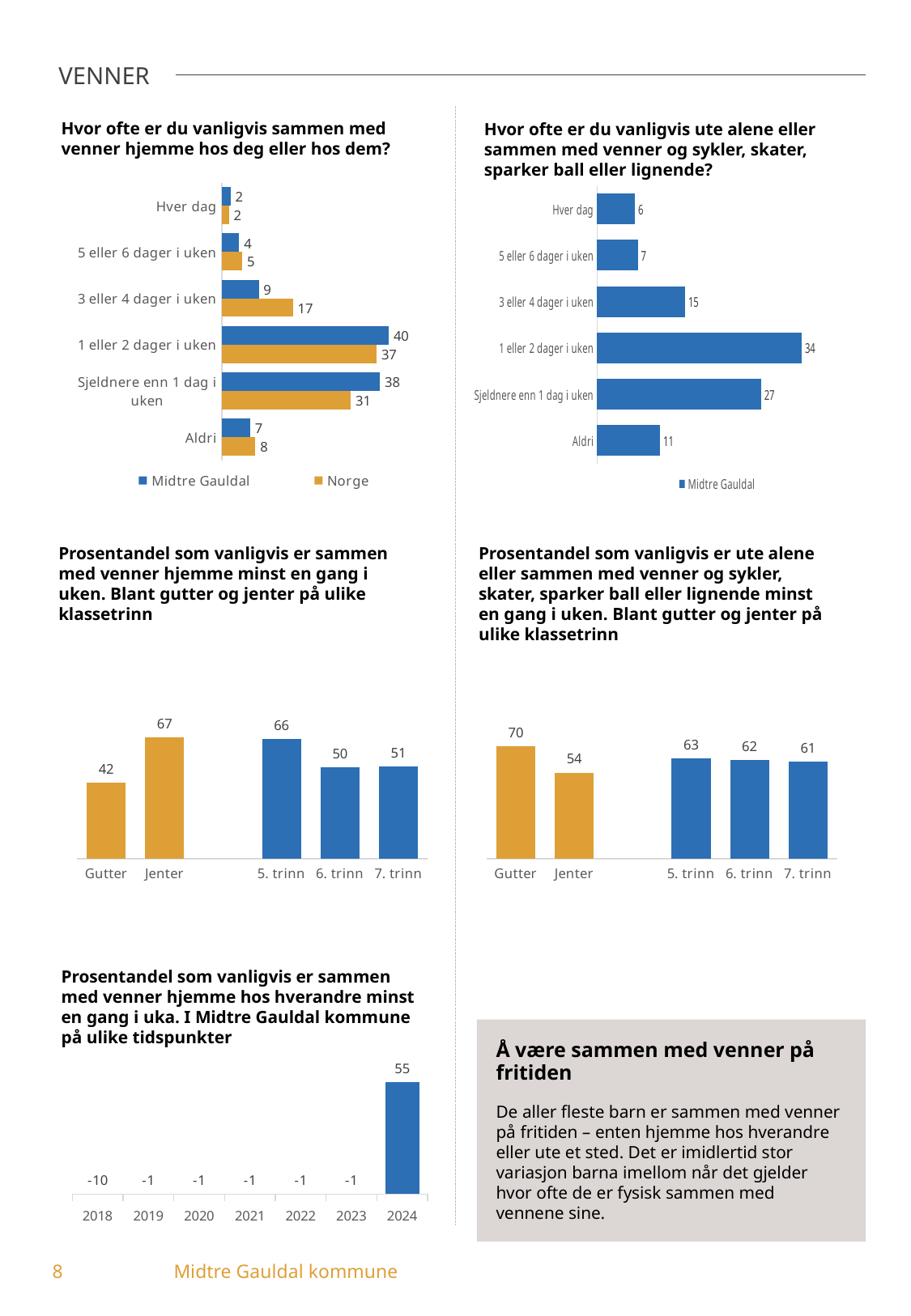
In the chart 'Hvor ofte er du vanligvis ute alene eller sammen med venner og sykler, skater, sparker ball eller lignende?', what is the value for 'Aldri'? 11 In the chart 'Prosentandel som vanligvis er ute alene eller sammen med venner og sykler, skater, sparker ball eller lignende minst en gang i uken', which is larger, Gutter or Jenter? Gutter In the chart 'Hvor ofte er du vanligvis ute alene eller sammen med venner og sykler, skater, sparker ball eller lignende?', how many categories are shown? 6 In the chart 'Hvor ofte er du vanligvis sammen med venner hjemme hos deg eller hos dem?', how many series does the legend list? 2 In the chart 'Hvor ofte er du vanligvis sammen med venner hjemme hos deg eller hos dem?', what is the Norge value for '3 eller 4 dager i uken'? 17 In the chart 'Hvor ofte er du vanligvis sammen med venner hjemme hos deg eller hos dem?', what is the Midtre Gauldal value for '1 eller 2 dager i uken'? 40 In the chart 'Prosentandel som vanligvis er sammen med venner hjemme minst en gang i uken', what is the value for Jenter? 67 In the chart 'Prosentandel som vanligvis er sammen med venner hjemme minst en gang i uken', which category has the lowest value? Gutter In the chart 'Prosentandel som vanligvis er sammen med venner hjemme hos hverandre minst en gang i uka. I Midtre Gauldal kommune på ulike tidspunkter', what is the value for 2024? 55 In the chart 'Hvor ofte er du vanligvis ute alene eller sammen med venner og sykler, skater, sparker ball eller lignende?', which category has the highest value? 1 eller 2 dager i uken In the chart 'Prosentandel som vanligvis er ute alene eller sammen med venner og sykler, skater, sparker ball eller lignende minst en gang i uken', what is the value for 6. trinn? 62 In the chart 'Hvor ofte er du vanligvis sammen med venner hjemme hos deg eller hos dem?', what is the difference between the Midtre Gauldal and Norge values for 'Sjeldnere enn 1 dag i uken'? 7